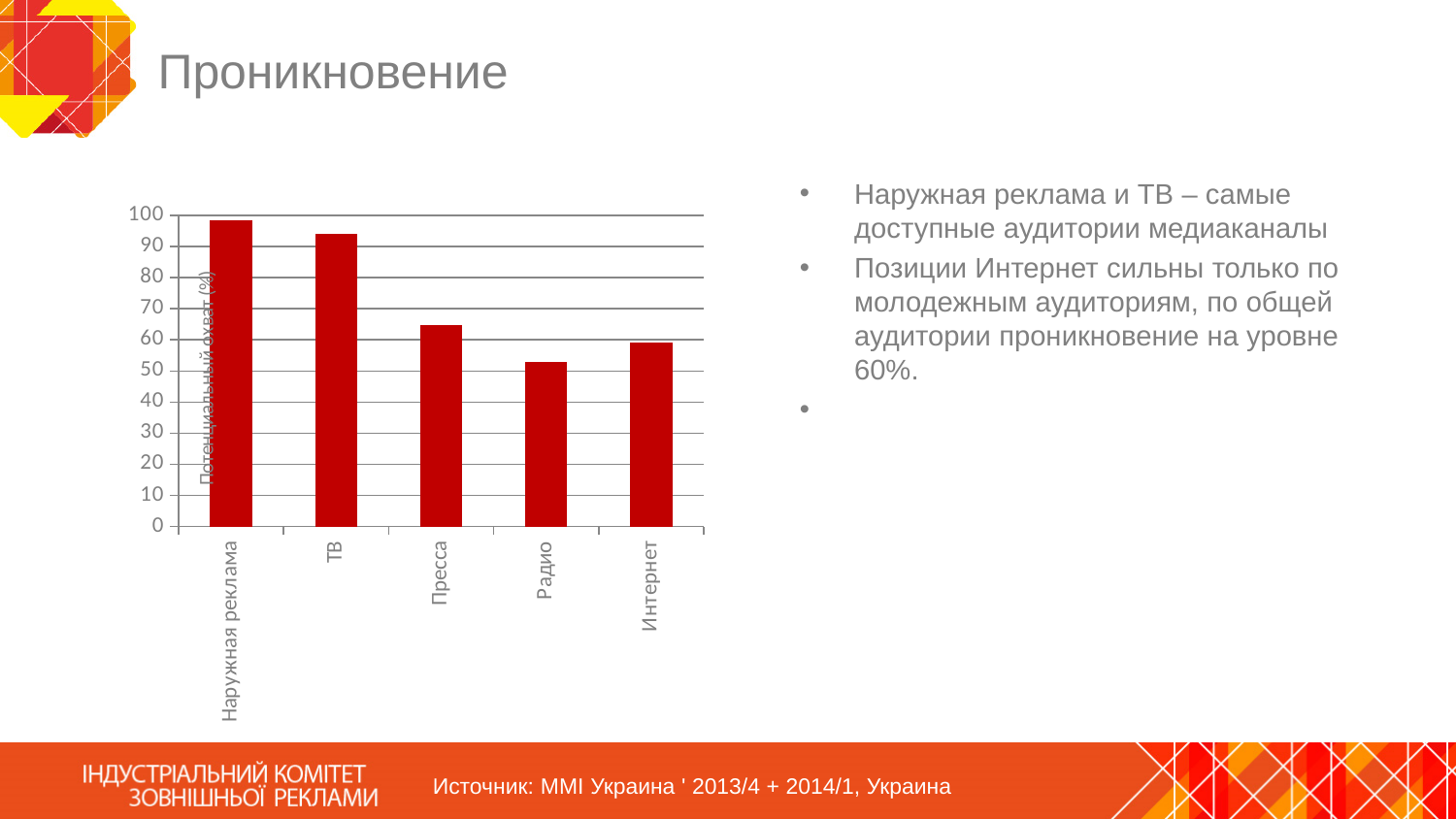
Is the value for Интернет greater or less than 50? greater Which category has the highest bar in the chart? Наружная реклама Is the value for Радио greater or less than 60? less Is the value for Наружная реклама greater or less than 90? greater Which is larger, the value for ТВ or the value for Пресса? ТВ Which is larger, the value for Радио or the value for Интернет? Интернет What kind of chart is shown on the slide? bar chart How many categories are shown on the x axis of the chart? 5 Which category has the lowest bar in the chart? Радио What is the label on the vertical axis of the chart? Потенциальный охват (%)